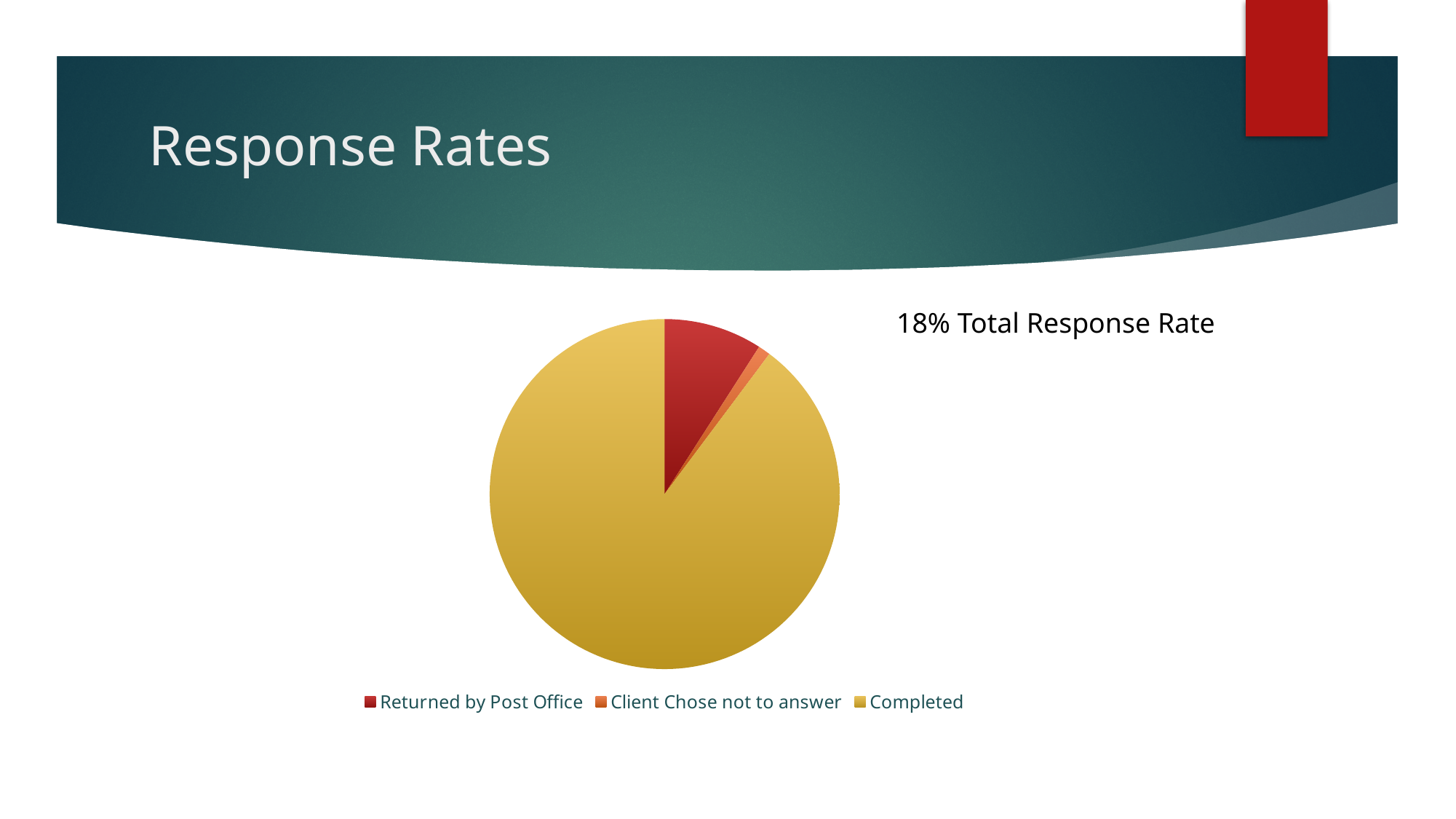
What kind of chart is shown on the slide? pie chart What is the title of the slide containing the pie chart? Response Rates What colour is the Completed slice in the pie chart? yellow How many slices does the pie chart have? 3 Which slice is larger: Returned by Post Office or Client Chose not to answer? Returned by Post Office How many entries does the legend of the pie chart list? 3 Which category has the smallest slice of the pie chart? Client Chose not to answer Which slice is larger: Completed or Returned by Post Office? Completed Which category has the largest slice of the pie chart? Completed